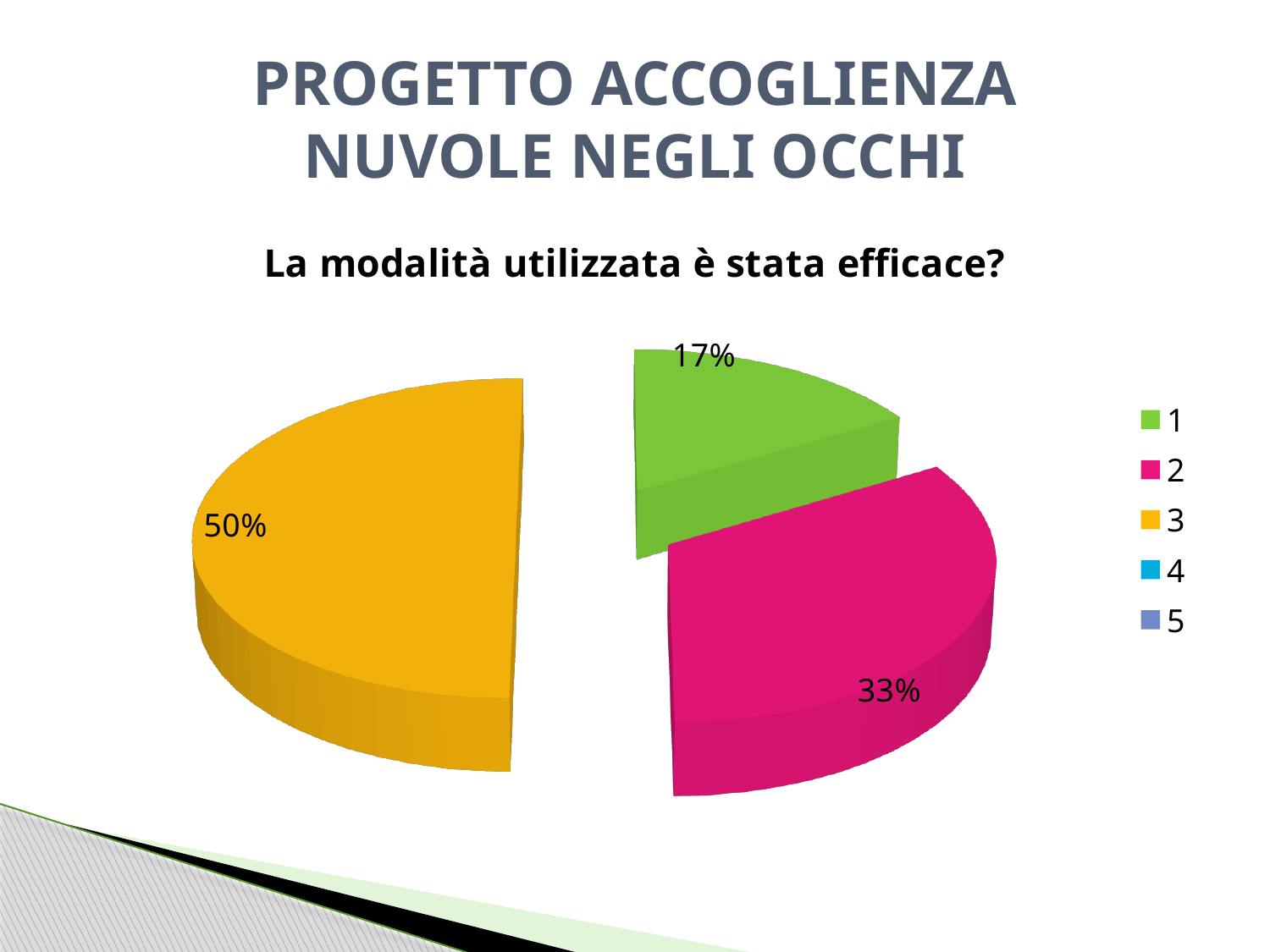
What is the chart's title? La modalità utilizzata è stata efficace? How many slices are visible in the pie? 3 What kind of chart is shown on the slide? pie chart What is the difference in percentage points between the slice for category 3 and the slice for category 2? 17% What share of the pie does category 1 have? 17% How many entries does the legend list? 5 What share of the pie does category 3 have? 50% Which of the visible slices is the smallest? 1 Which is larger, the slice for category 2 or the slice for category 1? 2 What share of the pie does category 2 have? 33% Which category has the largest slice of the pie? 3 What colour is the slice for category 3? yellow